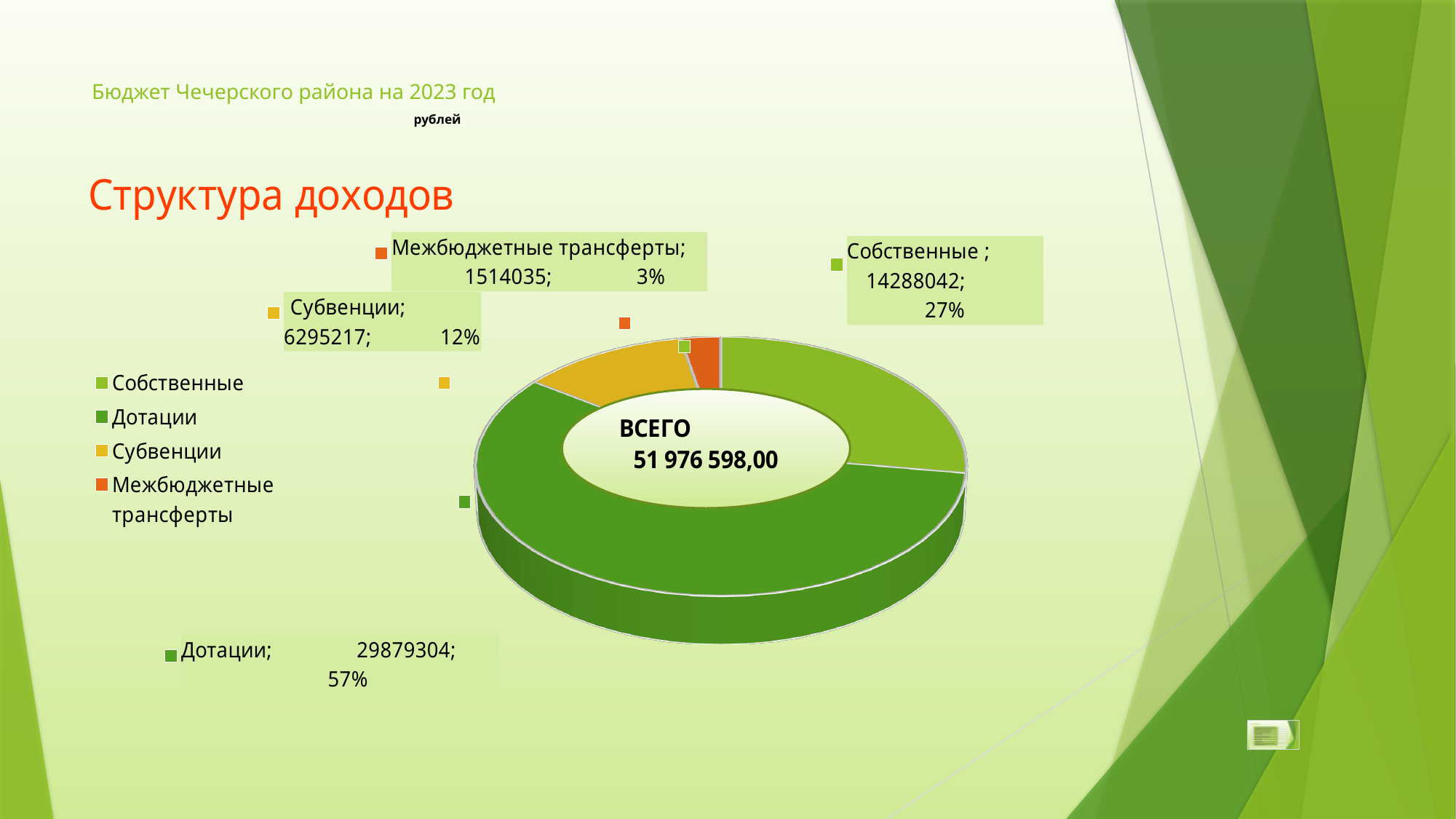
Which category has the smallest share of the chart? Межбюджетные трансферты What percentage share does Субвенции have? 12% What is the value for Собственные? 14288042 What is the difference between the values for Дотации and Собственные? 15591262 What is the value for Межбюджетные трансферты? 1514035 What is the value for Дотации? 29879304 What percentage share does Собственные have? 27% How many categories does the chart show? 4 Which is larger, the value for Субвенции or the value for Межбюджетные трансферты? Субвенции Which category has the largest share of the chart? Дотации What total (ВСЕГО) is shown in the centre of the chart? 51 976 598,00 What is the value for Субвенции? 6295217